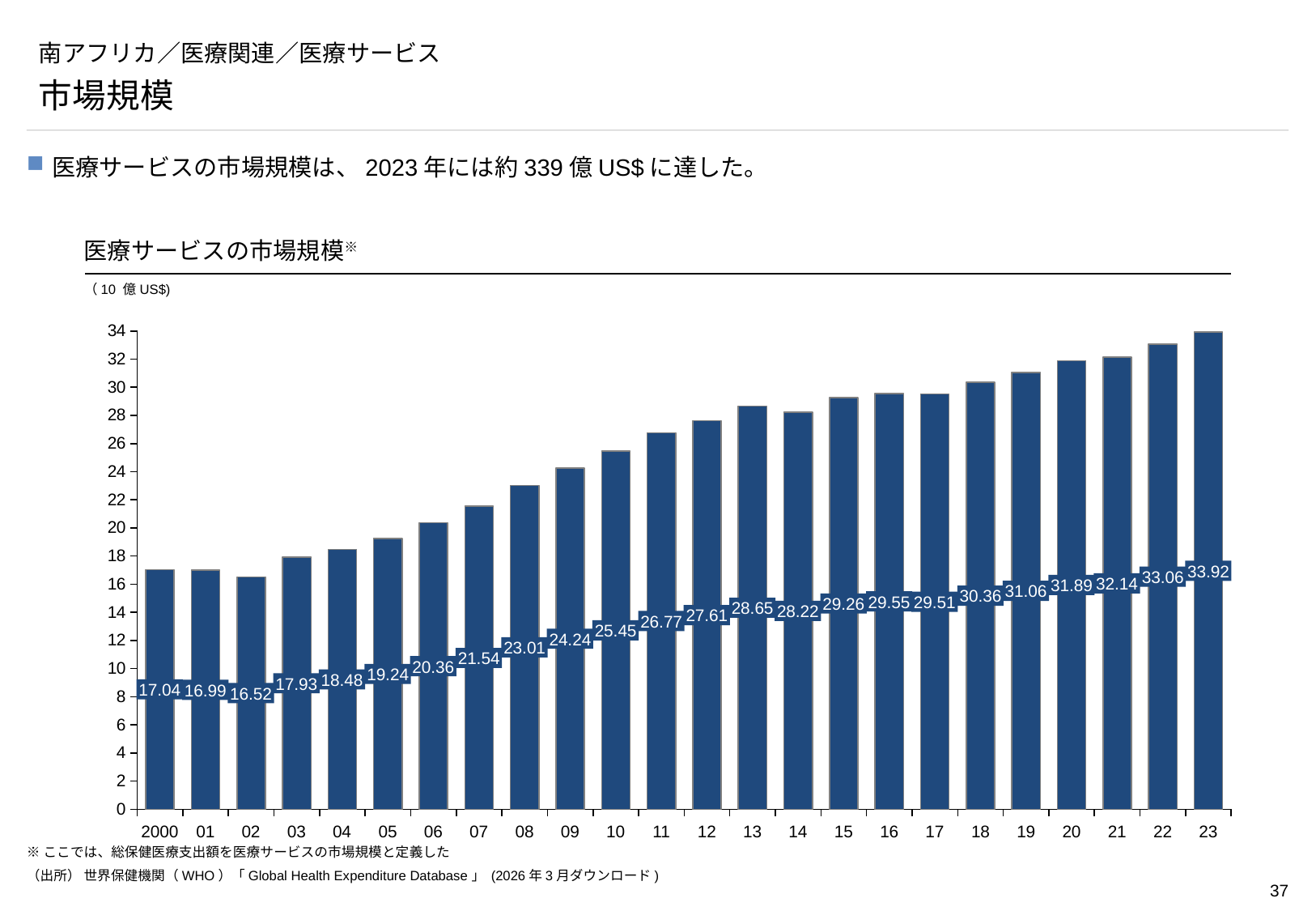
Which year has the lowest value in the chart? 02 What is the value for 2023 in the 医療サービスの市場規模 chart? 33.92 What is the difference between the values for 2023 and 2000? 16.88 How many years (bars) are shown in the chart? 24 What is the difference between the values for 13 and 14? 0.43 Is the value for 08 greater or less than 22? greater Which year has the highest value in the chart? 23 What is the value for 2010 in the chart? 25.45 What kind of chart is shown on the slide? bar chart Which is larger, the value for 13 or the value for 14? 13 What is the value for 2000 in the chart? 17.04 What unit is shown for the values in the chart? 10 億 US$